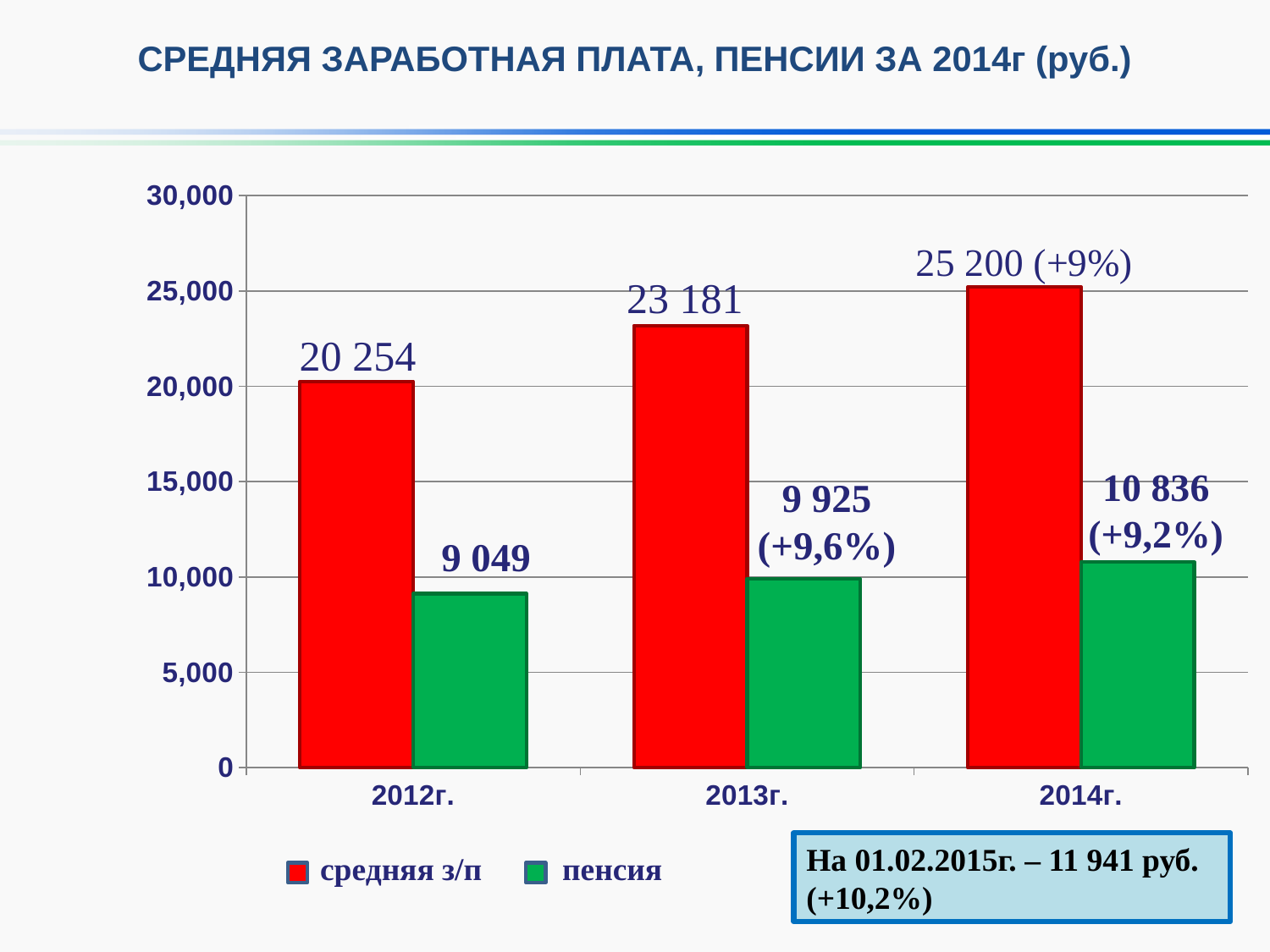
How many series does the legend list? 2 How many years are shown on the x axis? 3 Is the value of средняя з/п for 2014г. greater or less than 25,000? greater What is the difference between средняя з/п in 2014г. and 2012г.? 4 946 In which year is средняя з/п the highest? 2014г. What is the difference between пенсия in 2013г. and 2012г.? 876 What is the value of средняя з/п for 2013г.? 23 181 What is the value of пенсия for 2014г.? 10 836 In which year is пенсия the lowest? 2012г. Which is larger: средняя з/п in 2012г. or пенсия in 2014г.? средняя з/п in 2012г. What is the value of пенсия for 2012г.? 9 049 What kind of chart is shown on the slide? bar chart